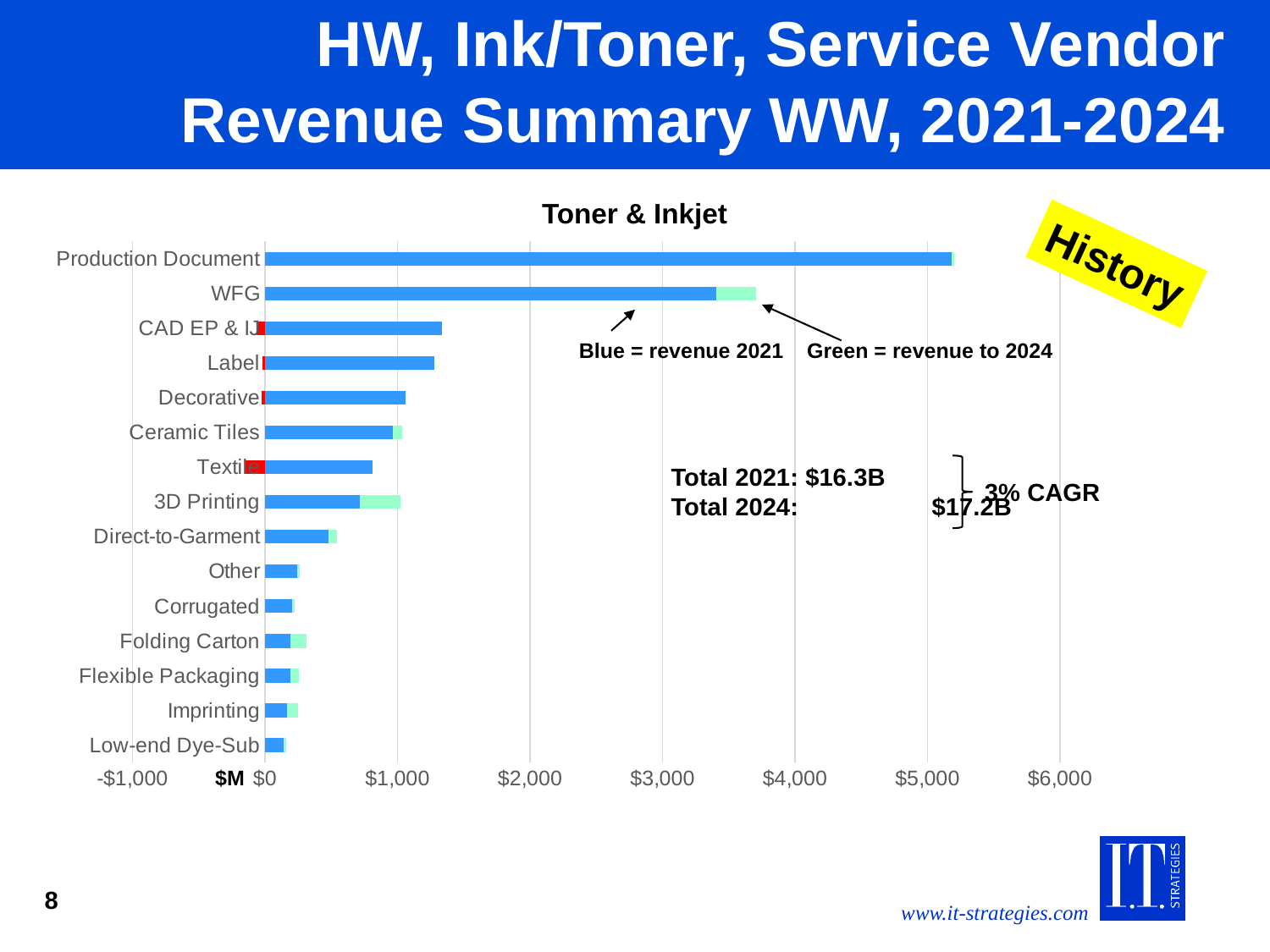
Is the 2021 revenue bar for Textile greater or less than $1,000? less Is the 2021 revenue bar for CAD EP & IJ greater or less than $2,000? less Is the 2021 revenue bar for WFG greater or less than $3,000? greater What kind of chart is shown on the slide? bar chart Which has the larger 2021 revenue bar, Label or Decorative? Label Which category has the longest bar in the Toner & Inkjet chart? Production Document According to the annotation on the chart, what does the blue portion of each bar represent? revenue 2021 Which category has the shortest bar in the Toner & Inkjet chart? Low-end Dye-Sub Which has the larger 2021 revenue bar, Production Document or WFG? Production Document How many categories are plotted in the Toner & Inkjet chart? 15